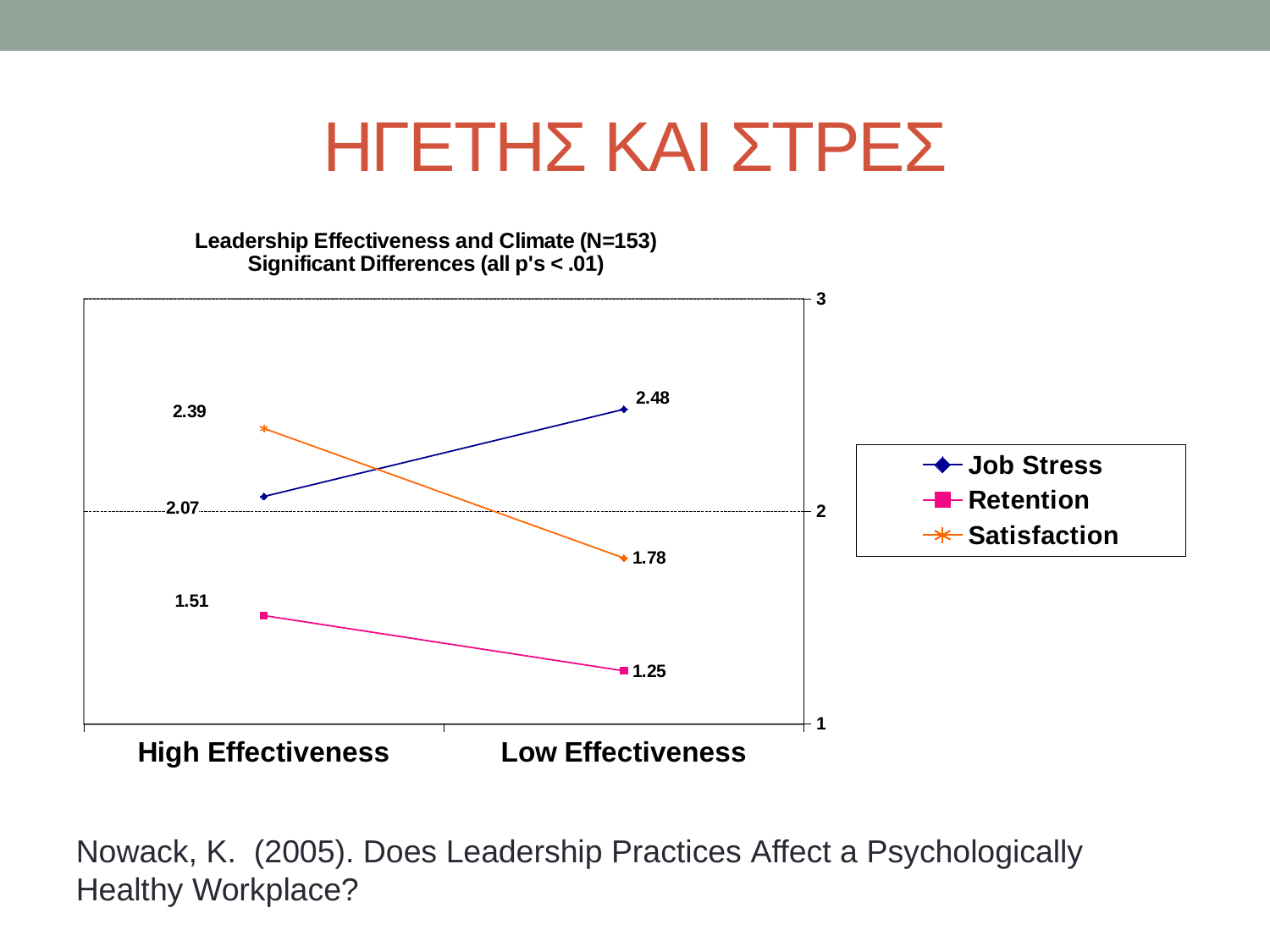
How many categories are shown on the x axis? 2 What is the Job Stress value for High Effectiveness? 2.07 Which series has the lowest value for Low Effectiveness? Retention What is the Satisfaction value for Low Effectiveness? 1.78 Does the Satisfaction line rise or fall from High Effectiveness to Low Effectiveness? fall How many series does the legend list? 3 Which series has the highest value for High Effectiveness? Satisfaction What is the Retention value for High Effectiveness? 1.51 What is the difference between the Retention values for High Effectiveness and Low Effectiveness? 0.26 What is the Job Stress value for Low Effectiveness? 2.48 What kind of chart is shown? line chart Which is larger: Job Stress for Low Effectiveness or Satisfaction for Low Effectiveness? Job Stress for Low Effectiveness